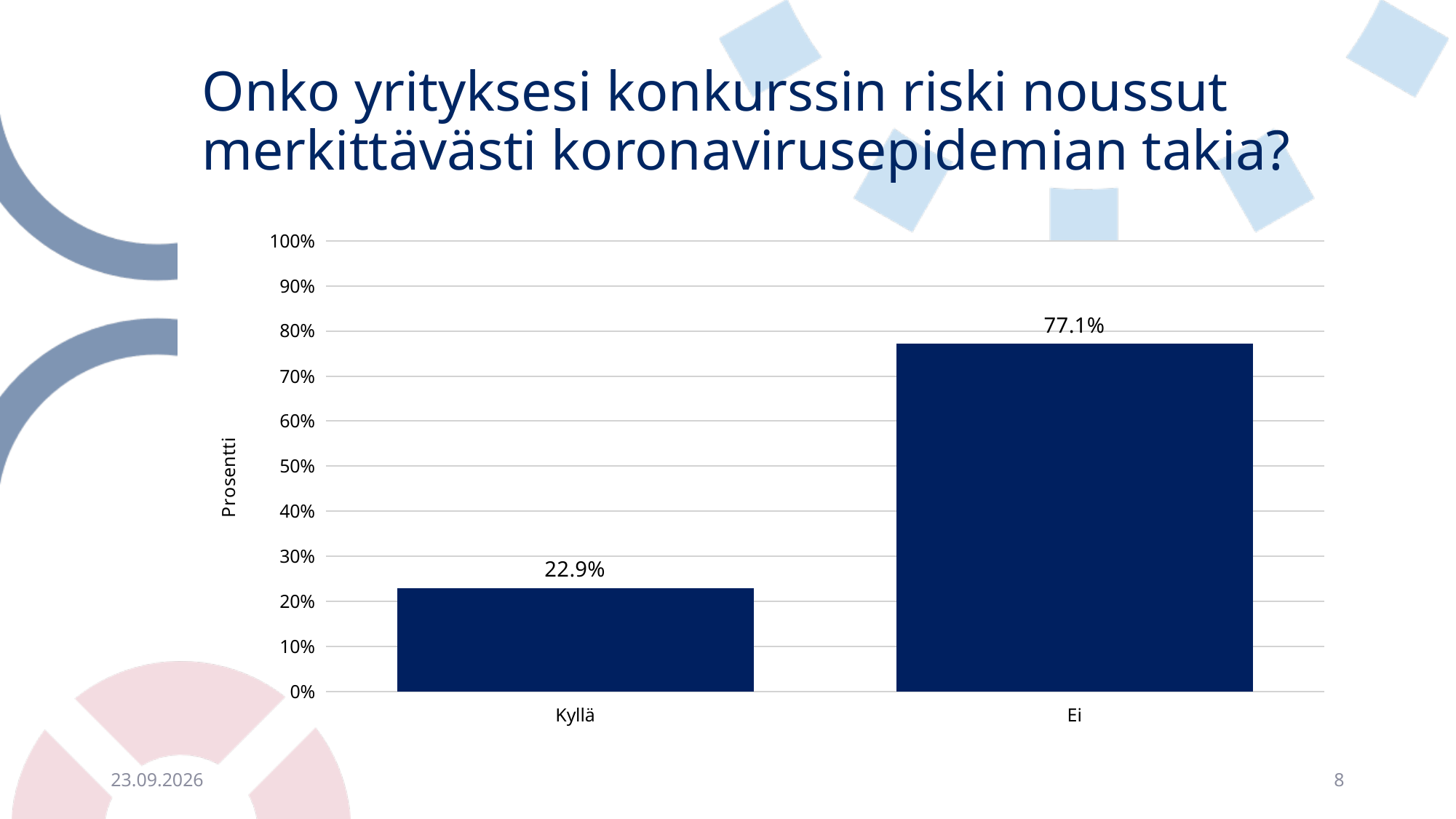
Which category has the lowest value? Kyllä What kind of chart is shown on the slide? bar chart Is the value for Ei greater or less than 70%? greater What is the highest value shown on the vertical axis? 100% What is the difference between the values for Ei and Kyllä? 54.2% Which category has the highest value? Ei What is the value for Ei? 77.1% Which is larger, the value for Kyllä or the value for Ei? Ei What is the value for Kyllä? 22.9% Is the value for Kyllä greater or less than 30%? less What is the label of the vertical axis? Prosentti How many categories are shown on the x axis? 2